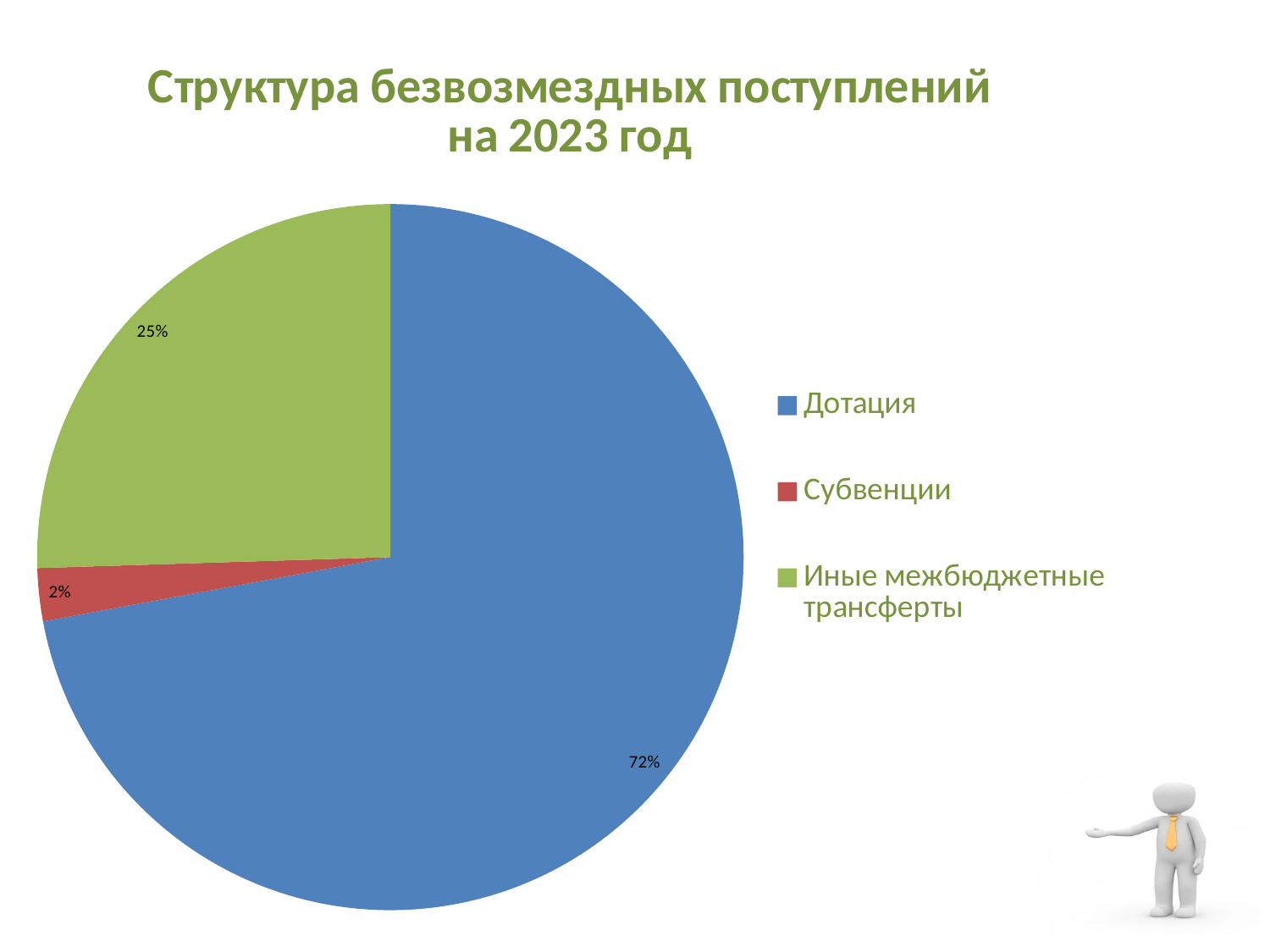
Which colour represents Субвенции in the pie chart? Red Which is larger, the share for Субвенции or the share for Иные межбюджетные трансферты? Иные межбюджетные трансферты Which category has the largest slice of the pie? Дотация What is the difference in percentage points between Дотация and Иные межбюджетные трансферты? 47 What share of the pie does Иные межбюджетные трансферты account for? 25% How many categories does the pie chart show? 3 What share of the pie does Субвенции account for? 2% What is the title of the chart? Структура безвозмездных поступлений на 2023 год What kind of chart is shown on the slide? Pie chart What share of the pie does Дотация account for? 72% Which category has the smallest slice of the pie? Субвенции What is the difference in percentage points between Иные межбюджетные трансферты and Субвенции? 23